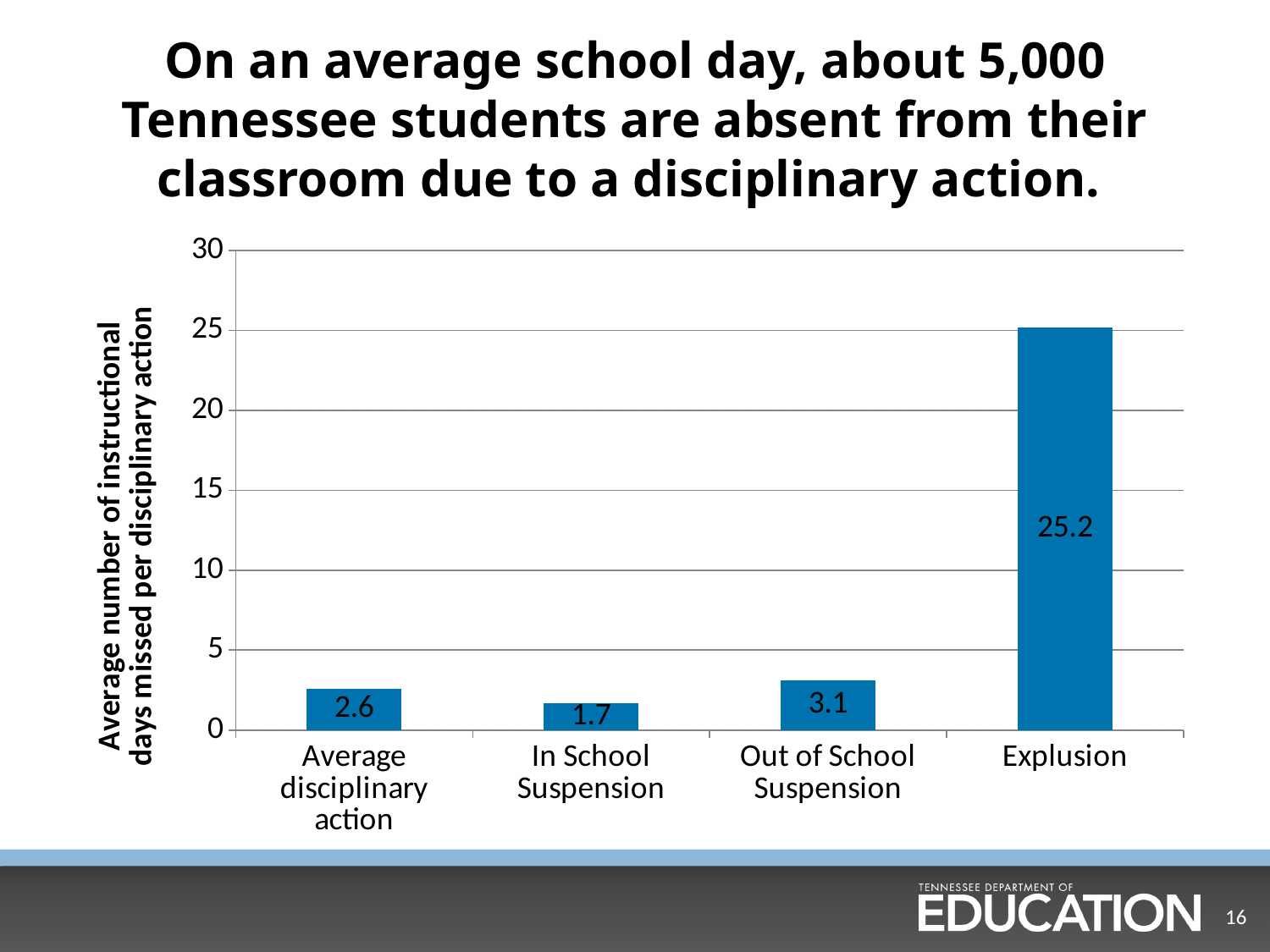
What is the average number of instructional days missed for Explusion? 25.2 What is the value shown for Average disciplinary action? 2.6 Which category has the highest average number of instructional days missed? Explusion What is the average number of instructional days missed for Out of School Suspension? 3.1 What is the difference between the values for Out of School Suspension and In School Suspension? 1.4 Is the value for Explusion greater or less than 20? greater What kind of chart is shown on the slide? Bar chart How many categories are shown on the x axis? 4 What is the average number of instructional days missed for In School Suspension? 1.7 What is the difference between the values for Explusion and Out of School Suspension? 22.1 Which is larger, the value for Out of School Suspension or the value for In School Suspension? Out of School Suspension Which category has the lowest average number of instructional days missed? In School Suspension